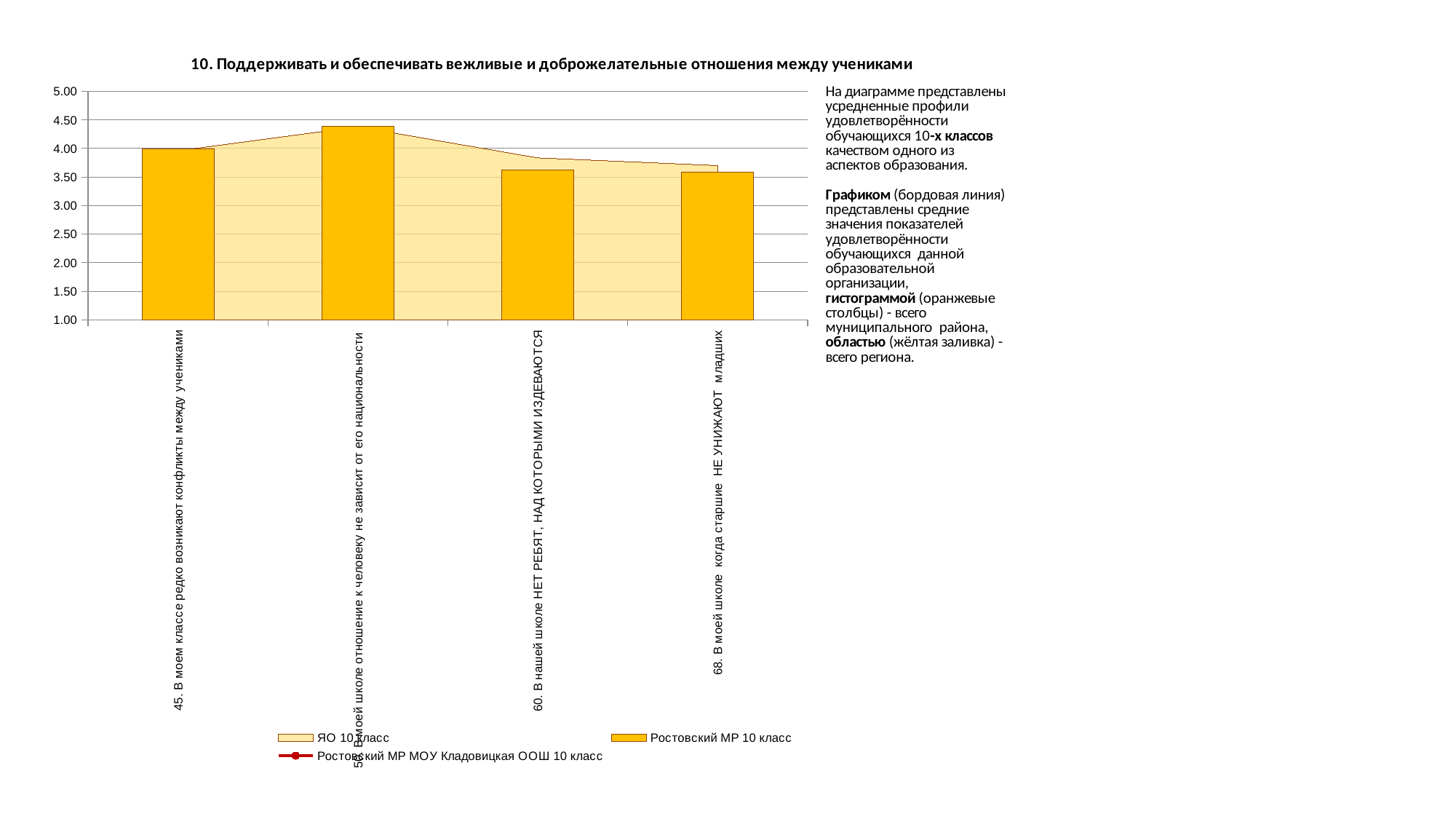
Is the Ростовский МР 10 класс value for the category about отношение к человеку не зависит от его национальности greater or less than 4.00? greater How many categories are shown on the x axis of the chart? 4 Is the Ростовский МР 10 класс value for category 60 greater or less than 4.00? less Is the Ростовский МР 10 класс value for category 45 greater or less than 3.50? greater Which category has the highest Ростовский МР 10 класс bar? В моей школе отношение к человеку не зависит от его национальности What is the title of the chart? 10. Поддерживать и обеспечивать вежливые и доброжелательные отношения между учениками For category 60, which series has the larger value: ЯО 10 класс or Ростовский МР 10 класс? ЯО 10 класс Do the Ростовский МР 10 класс values rise or fall from the second category to category 60? fall What kind of chart is used for the Ростовский МР 10 класс series? bar chart Which has the larger Ростовский МР 10 класс value: category 45 or category 60? category 45 How many series does the legend list? 3